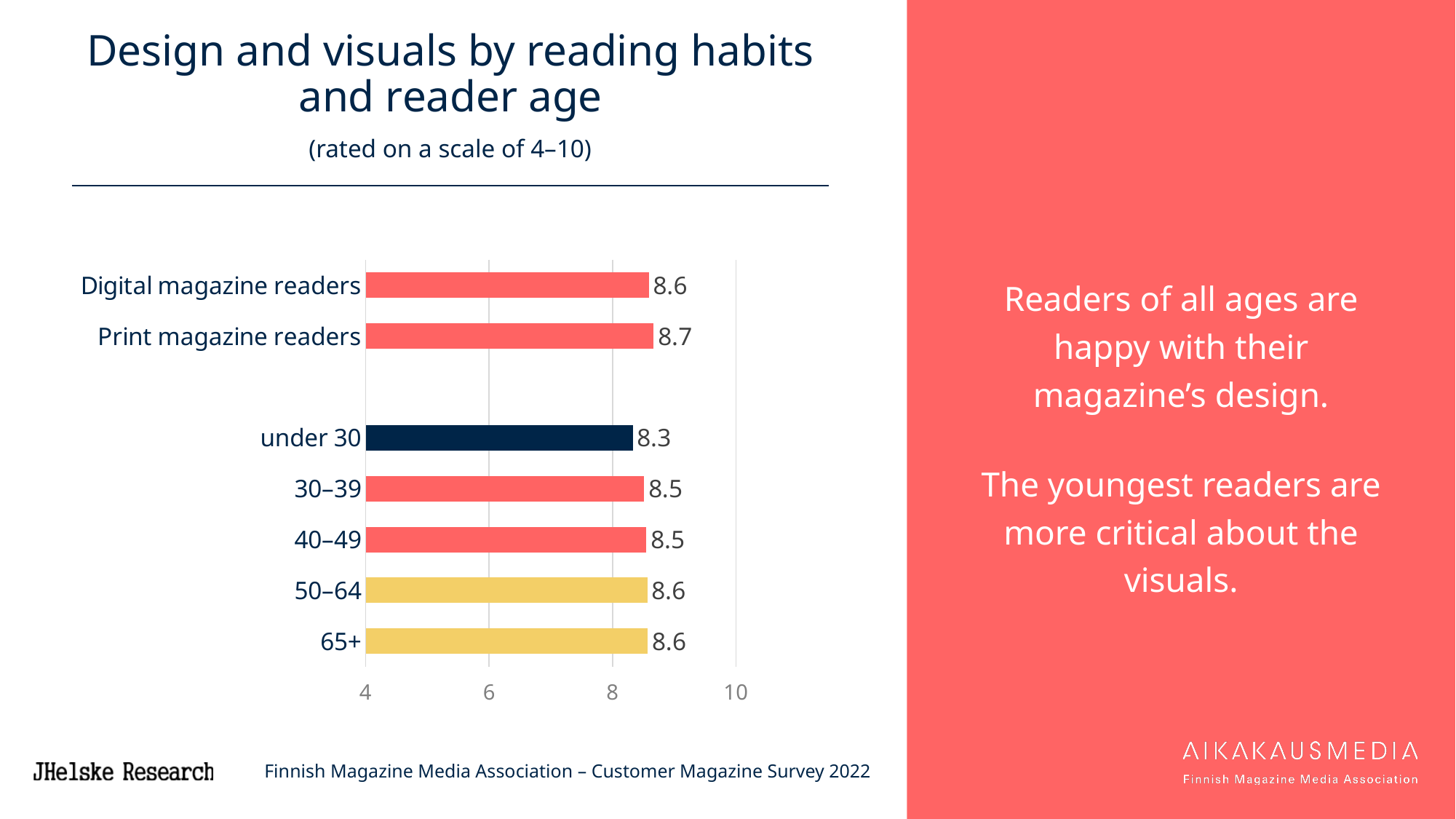
What is the rating for Digital magazine readers? 8.6 Is the rating for the 40–49 age group greater or less than 8? greater Which category has the highest rating? Print magazine readers What type of chart is shown on the slide? Bar chart What is the rating for readers under 30? 8.3 How many categories are shown in the chart? 7 What scale are the ratings given on, according to the subtitle? 4–10 What is the rating for Print magazine readers? 8.7 Which has a higher rating, Print magazine readers or Digital magazine readers? Print magazine readers What is the rating for the 50–64 age group? 8.6 Which category has the lowest rating? under 30 What is the difference between the ratings for Print magazine readers and readers under 30? 0.4